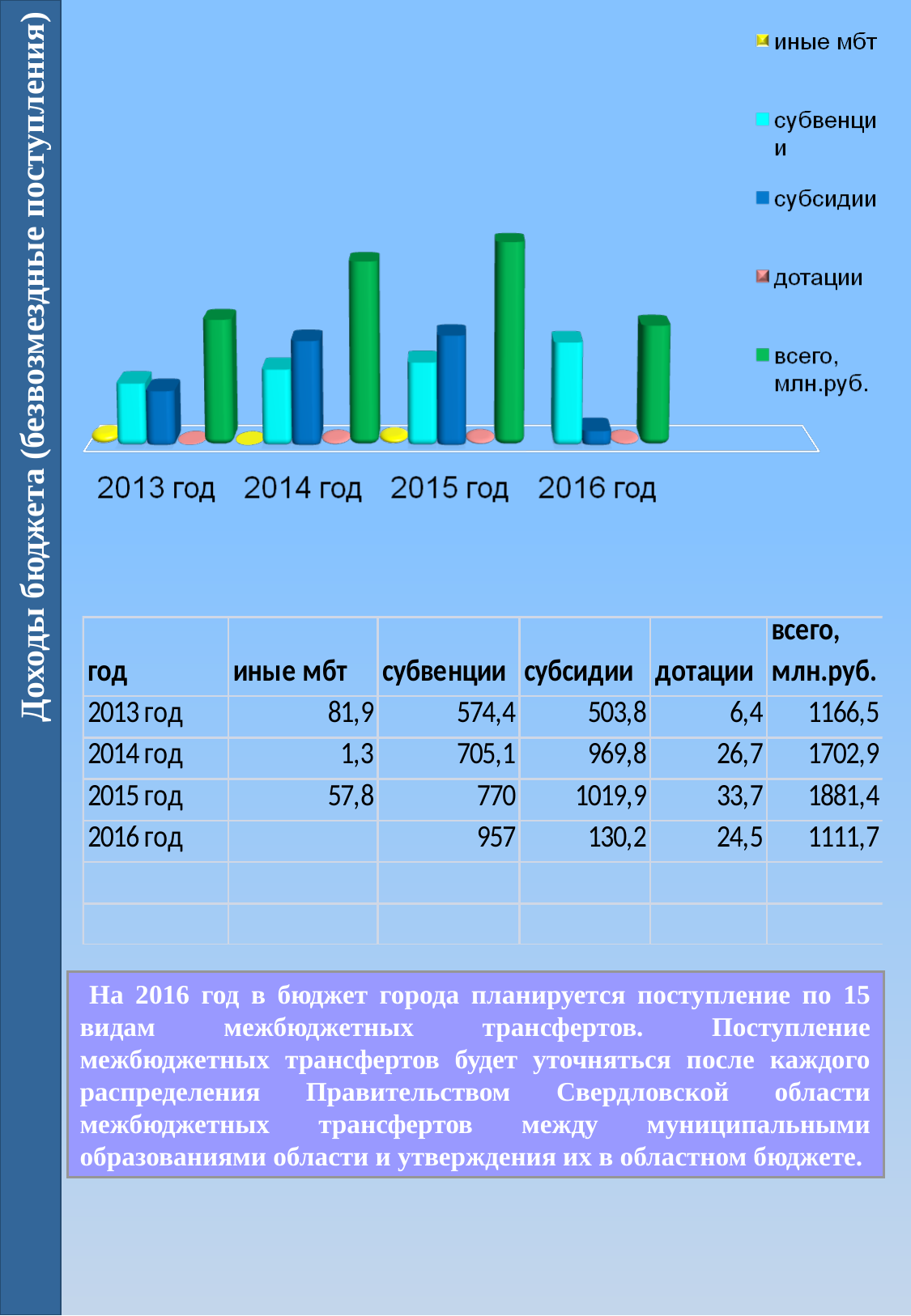
Which series in the legend is shown in green? всего, млн.руб. Is the value of "субсидии" larger in 2014 год or in 2016 год? 2014 год What kind of chart is shown on the slide? bar chart What is the difference between "всего, млн.руб." for 2015 год and 2013 год? 714,9 How many year categories are shown on the x axis of the chart? 4 Which year has the highest value for "всего, млн.руб."? 2015 год What is the value of "субвенции" for 2016 год? 957 Which year has the lowest value for "всего, млн.руб."? 2016 год Does the value of "всего, млн.руб." rise or fall from 2013 год to 2015 год? rise What is the value of "всего, млн.руб." for 2014 год? 1702,9 How many series does the chart legend list? 5 What is the value of "субсидии" for 2015 год? 1019,9